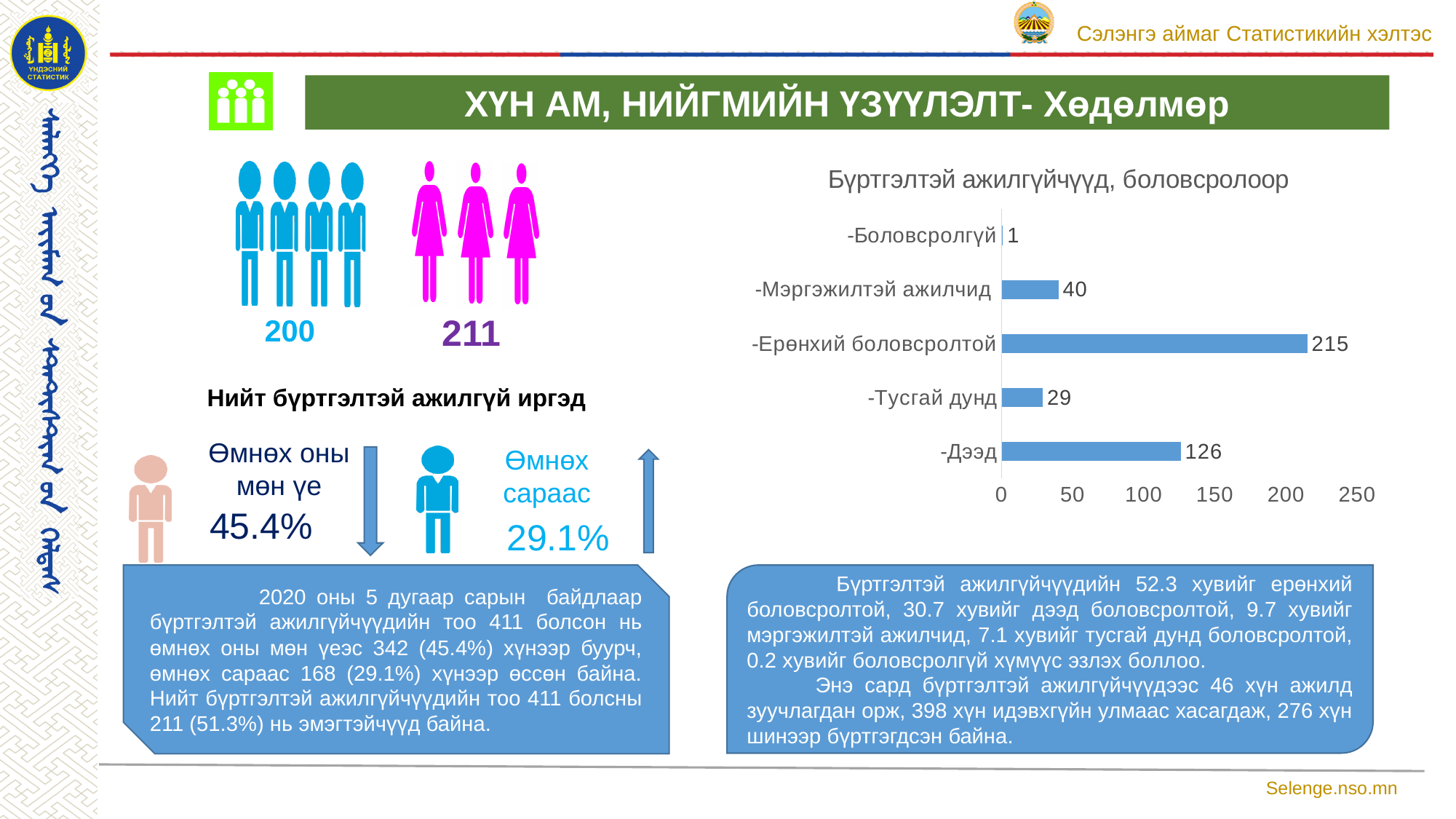
What is the value for -Дээд in the chart 'Бүртгэлтэй ажилгүйчүүд, боловсролоор'? 126 Which category has the highest value in the chart 'Бүртгэлтэй ажилгүйчүүд, боловсролоор'? -Ерөнхий боловсролтой What is the value for -Боловсролгүй in the chart 'Бүртгэлтэй ажилгүйчүүд, боловсролоор'? 1 What is the value for -Мэргэжилтэй ажилчид in the chart 'Бүртгэлтэй ажилгүйчүүд, боловсролоор'? 40 What is the value for -Ерөнхий боловсролтой in the chart 'Бүртгэлтэй ажилгүйчүүд, боловсролоор'? 215 In the chart 'Бүртгэлтэй ажилгүйчүүд, боловсролоор', what is the difference between the values for -Ерөнхий боловсролтой and -Дээд? 89 What is the value for -Тусгай дунд in the chart 'Бүртгэлтэй ажилгүйчүүд, боловсролоор'? 29 In the chart 'Бүртгэлтэй ажилгүйчүүд, боловсролоор', is the value for -Дээд greater or less than 100? greater How many categories are shown in the chart 'Бүртгэлтэй ажилгүйчүүд, боловсролоор'? 5 Which category has the lowest value in the chart 'Бүртгэлтэй ажилгүйчүүд, боловсролоор'? -Боловсролгүй In the chart 'Бүртгэлтэй ажилгүйчүүд, боловсролоор', which is larger: -Мэргэжилтэй ажилчид or -Тусгай дунд? -Мэргэжилтэй ажилчид What kind of chart is 'Бүртгэлтэй ажилгүйчүүд, боловсролоор'? bar chart